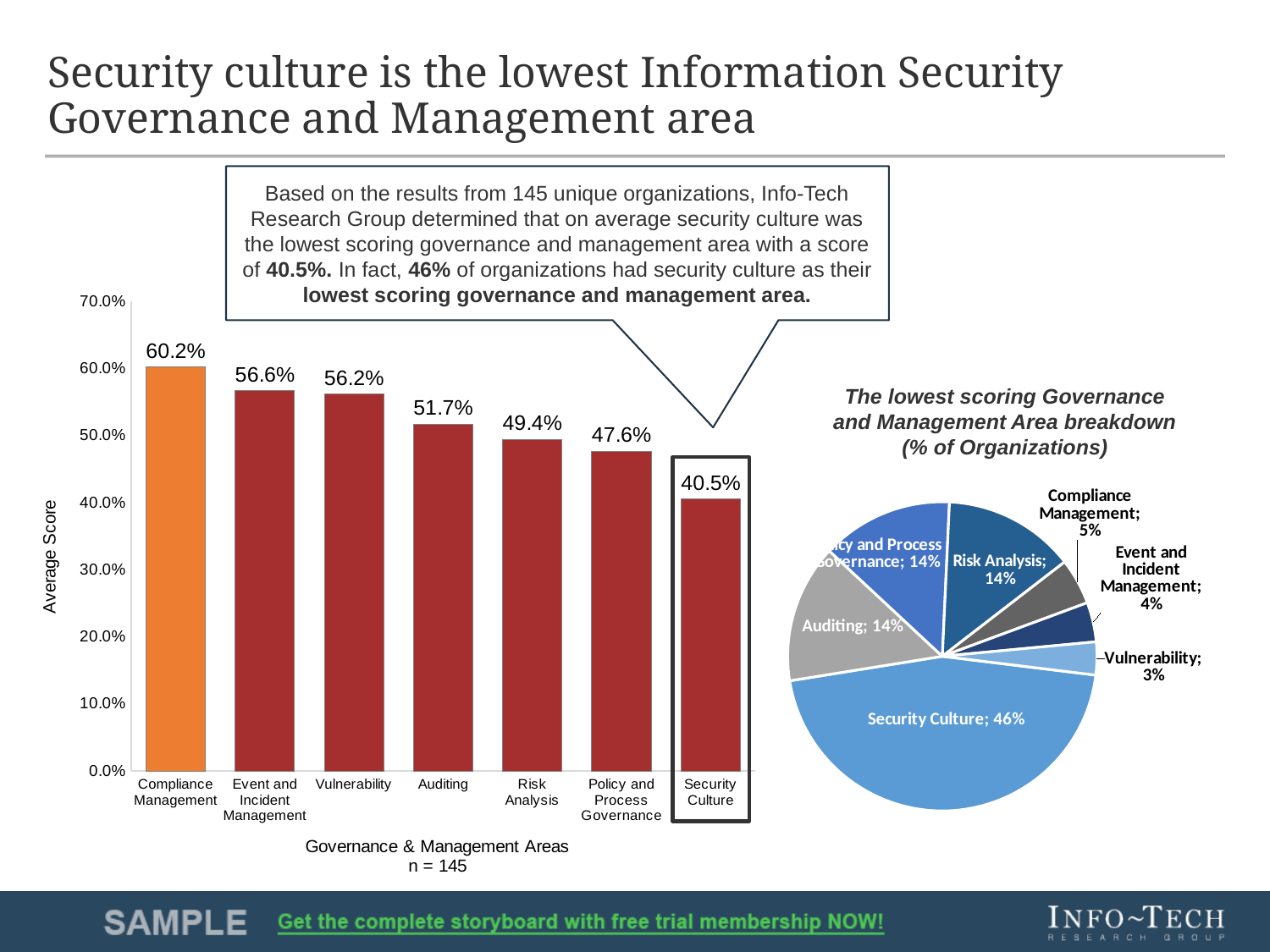
How many governance and management areas are shown in the bar chart on the left? 7 Do the average scores in the bar chart on the left rise or fall from left to right? Fall In the pie chart on the right, what percentage is shown for Vulnerability? 3% In the bar chart on the left, what is the average score for Compliance Management? 60.2% In the pie chart on the right, what share of organizations had Security Culture as their lowest scoring area? 46% In the bar chart on the left, what is the average score for Security Culture? 40.5% In the bar chart on the left, what is the difference between the average scores for Compliance Management and Security Culture? 19.7% In the bar chart on the left, which has a higher average score, Auditing or Risk Analysis? Auditing In the bar chart on the left, which governance and management area has the lowest average score? Security Culture What is the sample size (n) stated below the bar chart on the left? n = 145 In the bar chart on the left, which governance and management area has the highest average score? Compliance Management What type of chart is the chart on the left of the slide? Bar chart